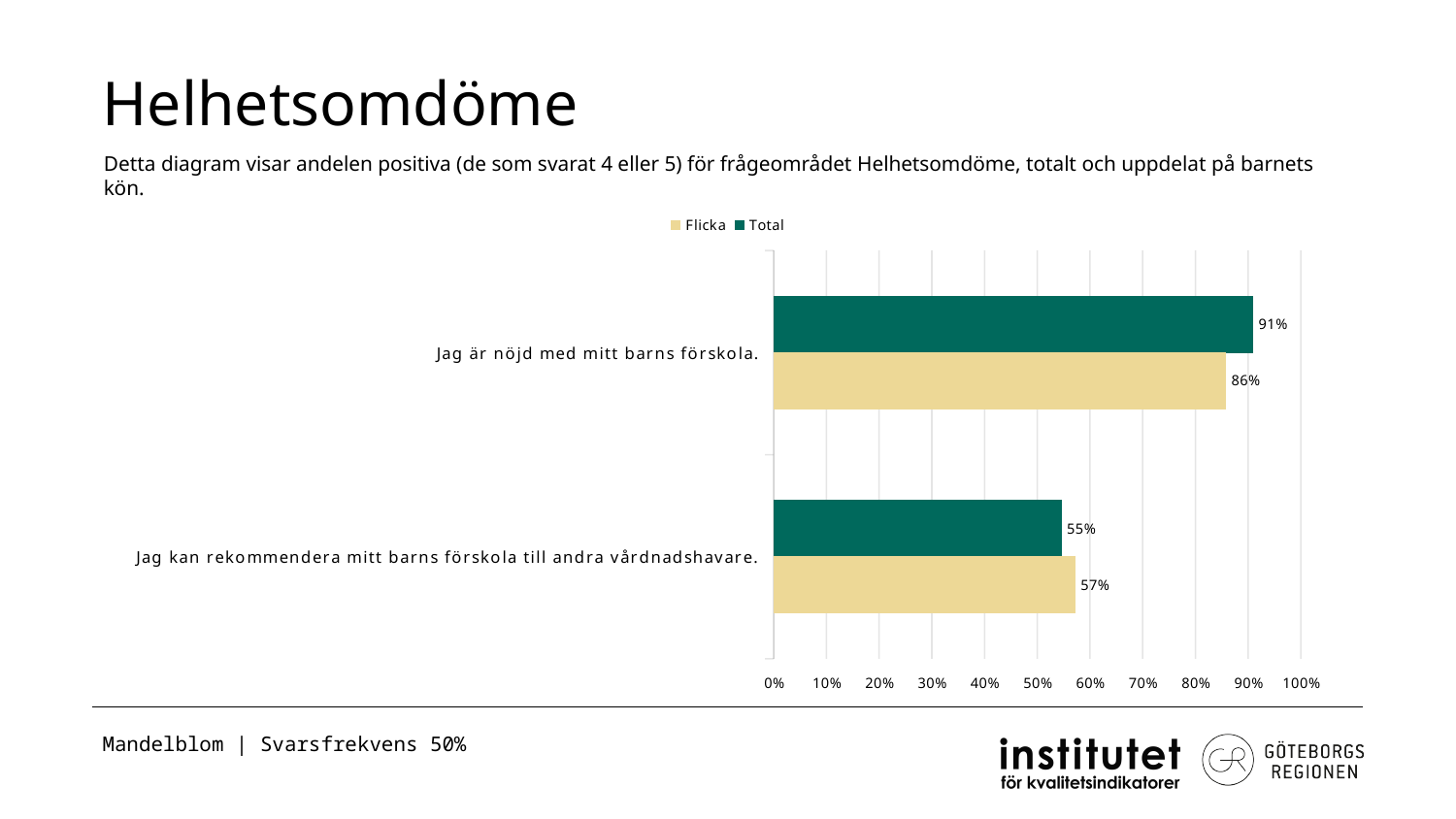
For "Jag kan rekommendera mitt barns förskola till andra vårdnadshavare.", which is larger, the Flicka value or the Total value? Flicka What is the Flicka value for "Jag kan rekommendera mitt barns förskola till andra vårdnadshavare."? 57% Which category has the lowest Flicka value? Jag kan rekommendera mitt barns förskola till andra vårdnadshavare. What is the difference between the Total and Flicka values for "Jag är nöjd med mitt barns förskola."? 5% What is the Flicka value for "Jag är nöjd med mitt barns förskola."? 86% What is the Total value for "Jag är nöjd med mitt barns förskola."? 91% What type of chart is shown on the slide? bar chart Which category has the highest Total value? Jag är nöjd med mitt barns förskola. Which legend entry is shown in dark green? Total What is the Total value for "Jag kan rekommendera mitt barns förskola till andra vårdnadshavare."? 55% How many categories are shown on the chart? 2 How many series does the legend list? 2